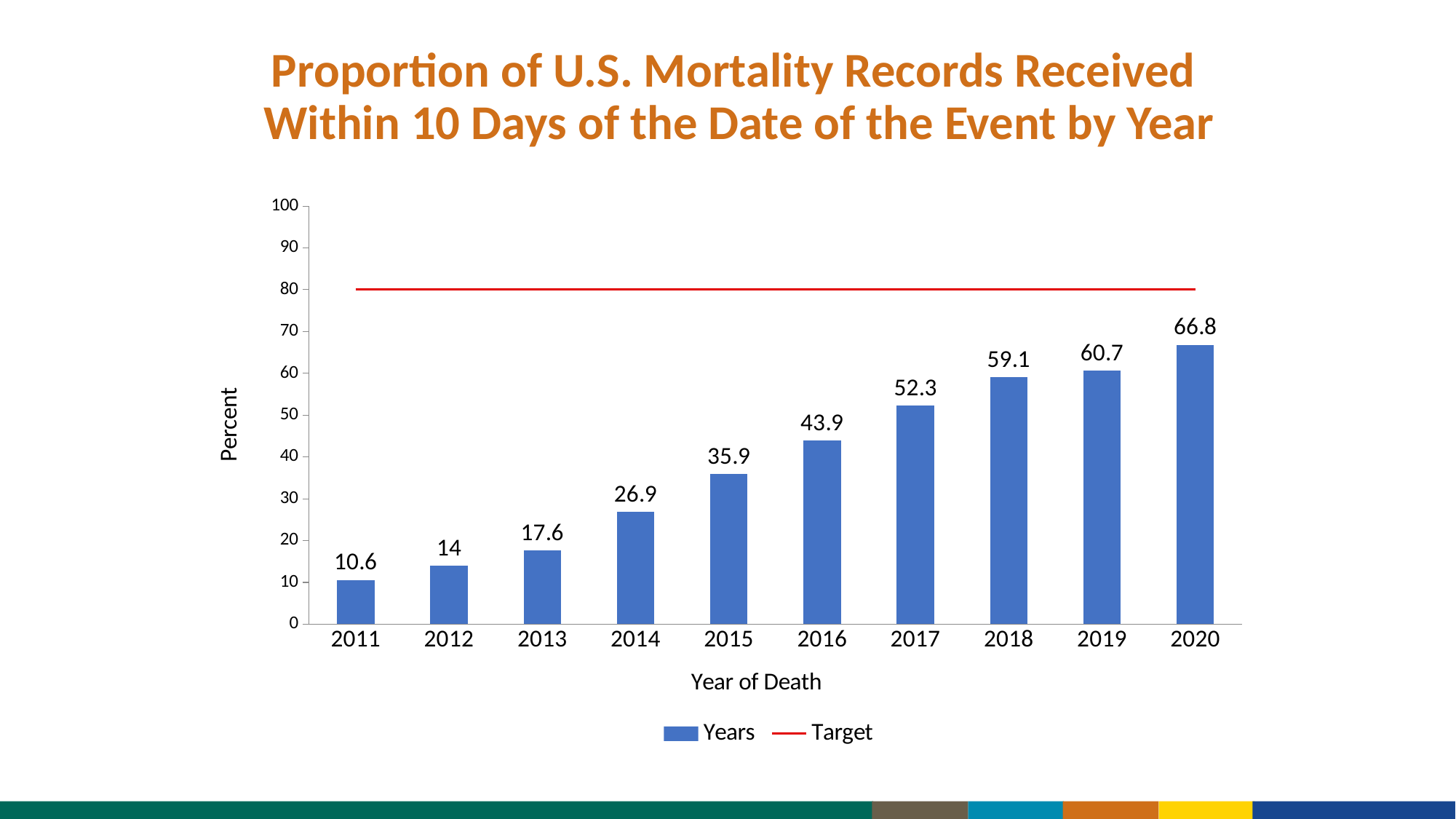
How many series does the legend list? 2 What kind of chart is this? combination bar and line chart What is the value for 2015? 35.9 What is the value for 2012? 14 Do the bar values rise or fall from 2011 to 2020? rise What is the difference between the values for 2017 and 2016? 8.4 What is the difference between the values for 2020 and 2011? 56.2 Which year has the highest value? 2020 Which year has the lowest value? 2011 Which is larger, the value for 2014 or the value for 2013? 2014 How many years are shown on the x axis? 10 Is the Target line greater or less than 70? greater